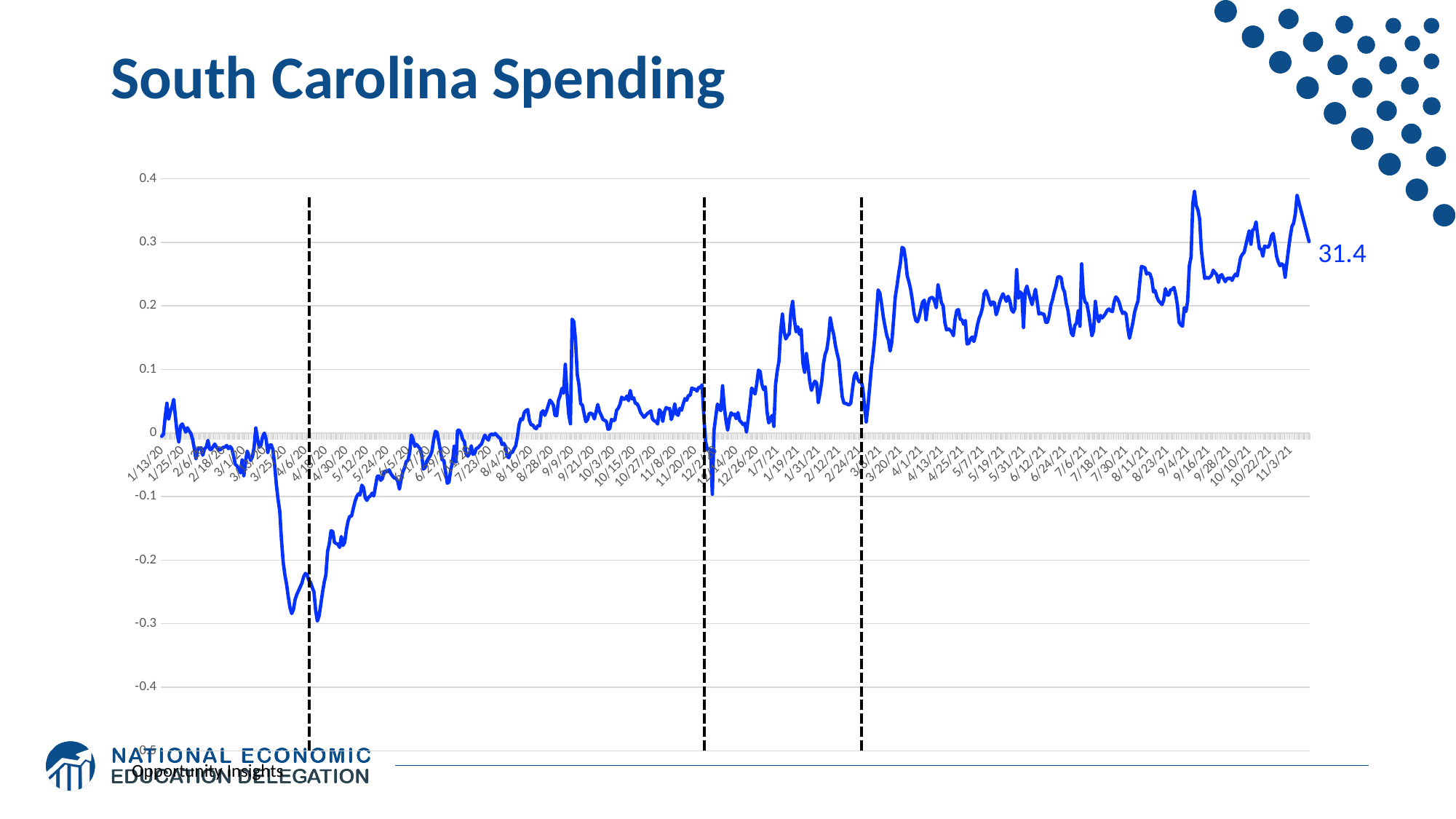
In which month does the line reach its lowest point? April 2020 Which is larger, the value around 4/18/20 or the value around 9/4/21? 9/4/21 Is the value at the end of the line (11/3/21) greater or less than 0.2? greater What kind of chart is shown on the slide? line chart Overall, does the line rise or fall from the start of the x axis (1/13/20) to the end (11/3/21)? rise What value is printed as the data label at the end of the line? 31.4 What is the title of the chart? South Carolina Spending Is the value at 1/13/20 greater or less than 0.1? less Is the value around 3/20/21 greater or less than 0.1? greater How many dashed vertical lines are drawn on the chart? 3 Which is larger, the value at 1/13/20 or the value at 11/3/21? 11/3/21